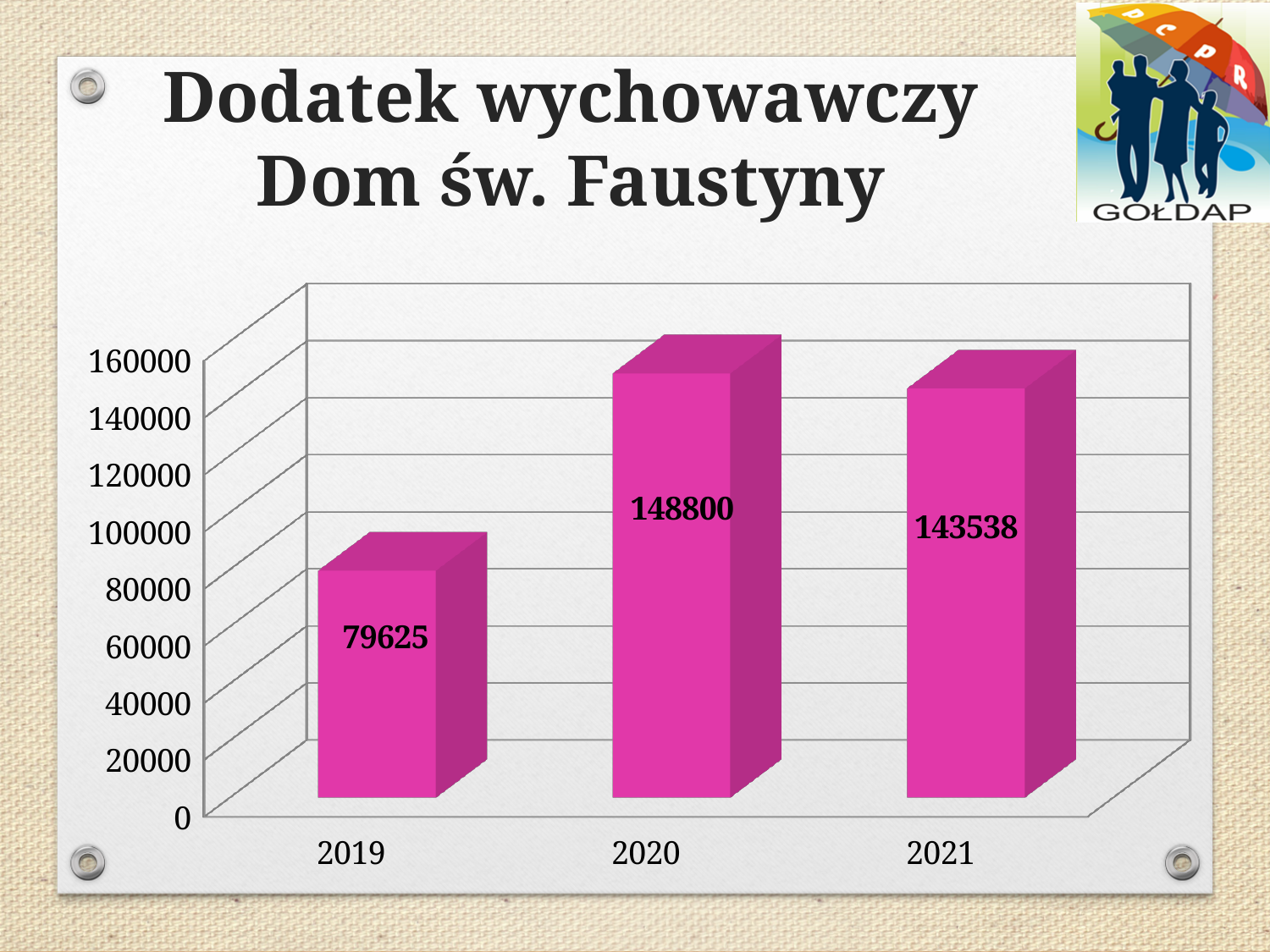
What is the value for 2020? 148800 What is the value for 2021? 143538 Which year has the lowest value? 2019 What kind of chart is shown on the slide? bar chart Which year has the highest value? 2020 What is the difference between the values for 2020 and 2019? 69175 Which is larger, the value for 2021 or the value for 2019? 2021 What is the value for 2019? 79625 How many years are shown on the chart? 3 What is the difference between the values for 2020 and 2021? 5262 What is the title of the slide? Dodatek wychowawczy Dom św. Faustyny Is the value for 2019 greater or less than 100000? less